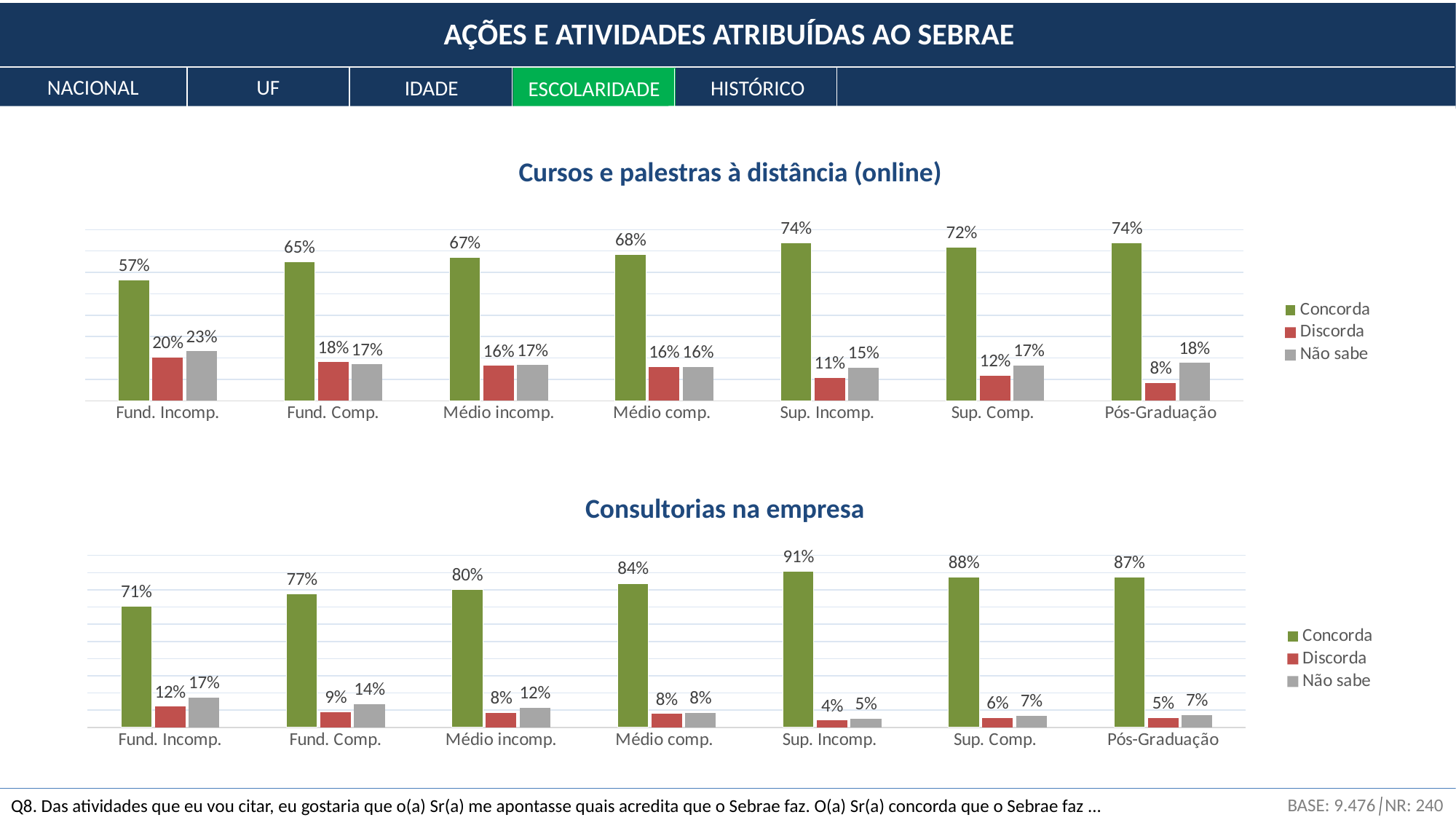
In the 'Cursos e palestras à distância (online)' chart, which is larger for Fund. Incomp.: Discorda or Não sabe? Não sabe How many categories are shown on the x axis of the 'Consultorias na empresa' chart? 7 In the 'Cursos e palestras à distância (online)' chart, which category has the lowest Concorda value? Fund. Incomp. What type of chart is 'Consultorias na empresa'? Bar chart Which colour represents the Concorda series in the 'Cursos e palestras à distância (online)' chart? Green In the 'Consultorias na empresa' chart, what is the Discorda value for Sup. Incomp.? 4% How many series does the legend of the 'Cursos e palestras à distância (online)' chart list? 3 In the 'Consultorias na empresa' chart, do the Discorda values generally rise or fall from Fund. Incomp. to Pós-Graduação? Fall In the 'Cursos e palestras à distância (online)' chart, what is the Concorda value for Fund. Incomp.? 57% In the 'Consultorias na empresa' chart, which category has the highest Concorda value? Sup. Incomp. In the 'Cursos e palestras à distância (online)' chart, what is the Não sabe value for Pós-Graduação? 18% In the 'Consultorias na empresa' chart, what is the difference between the Concorda values for Sup. Incomp. and Fund. Incomp.? 20%